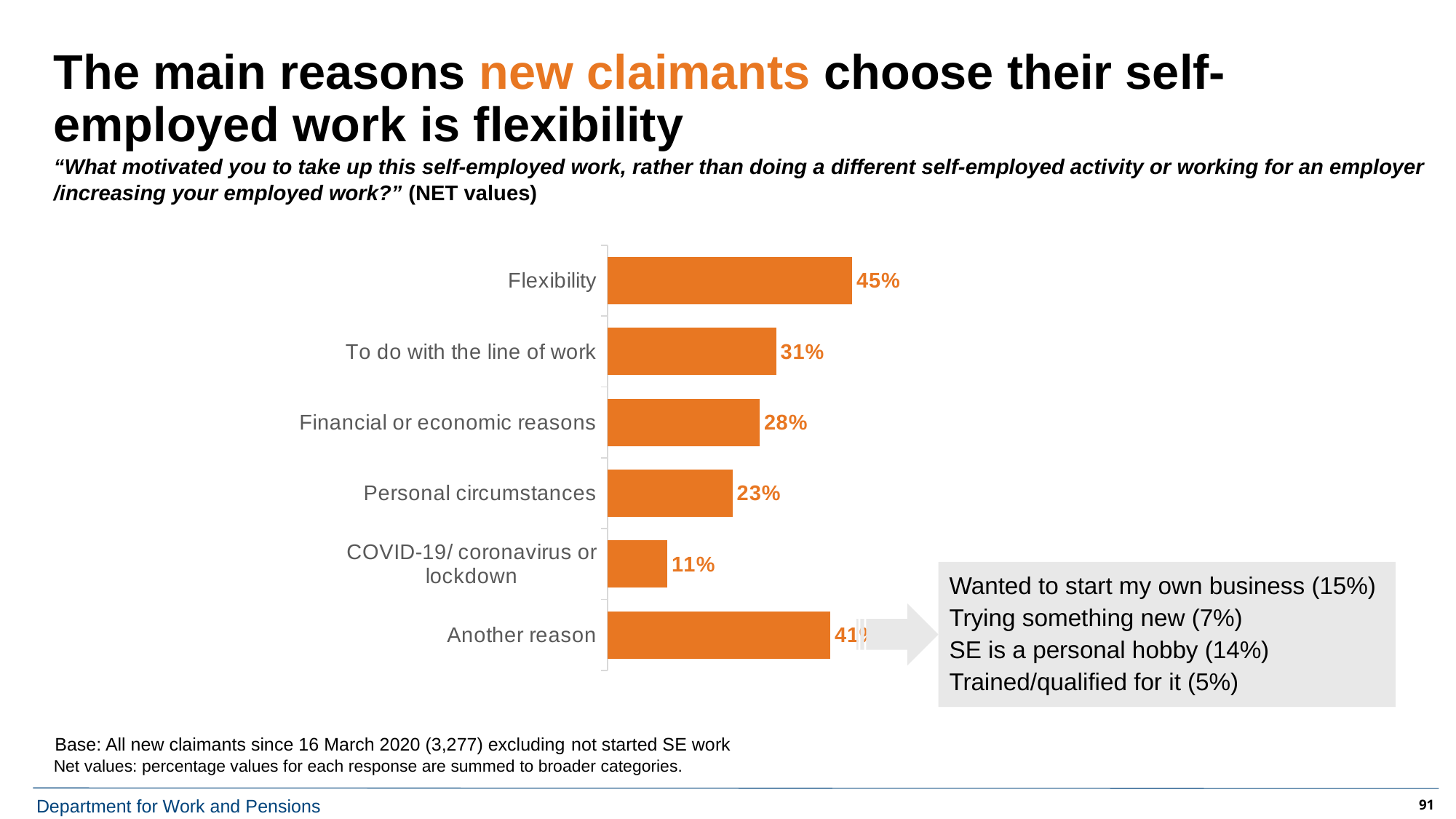
What colour are the bars in the chart? Orange What is the difference between the values for Flexibility and To do with the line of work? 14 percentage points How many categories are shown in the chart? 6 Which is larger, the value for Financial or economic reasons or the value for Personal circumstances? Financial or economic reasons What is the value for Flexibility? 45% What is the value for COVID-19/ coronavirus or lockdown? 11% What is the value for Financial or economic reasons? 28% Which category has the lowest value? COVID-19/ coronavirus or lockdown What is the value for To do with the line of work? 31% Which category has the highest value? Flexibility What is the value for Personal circumstances? 23% What kind of chart is shown on the slide? Bar chart